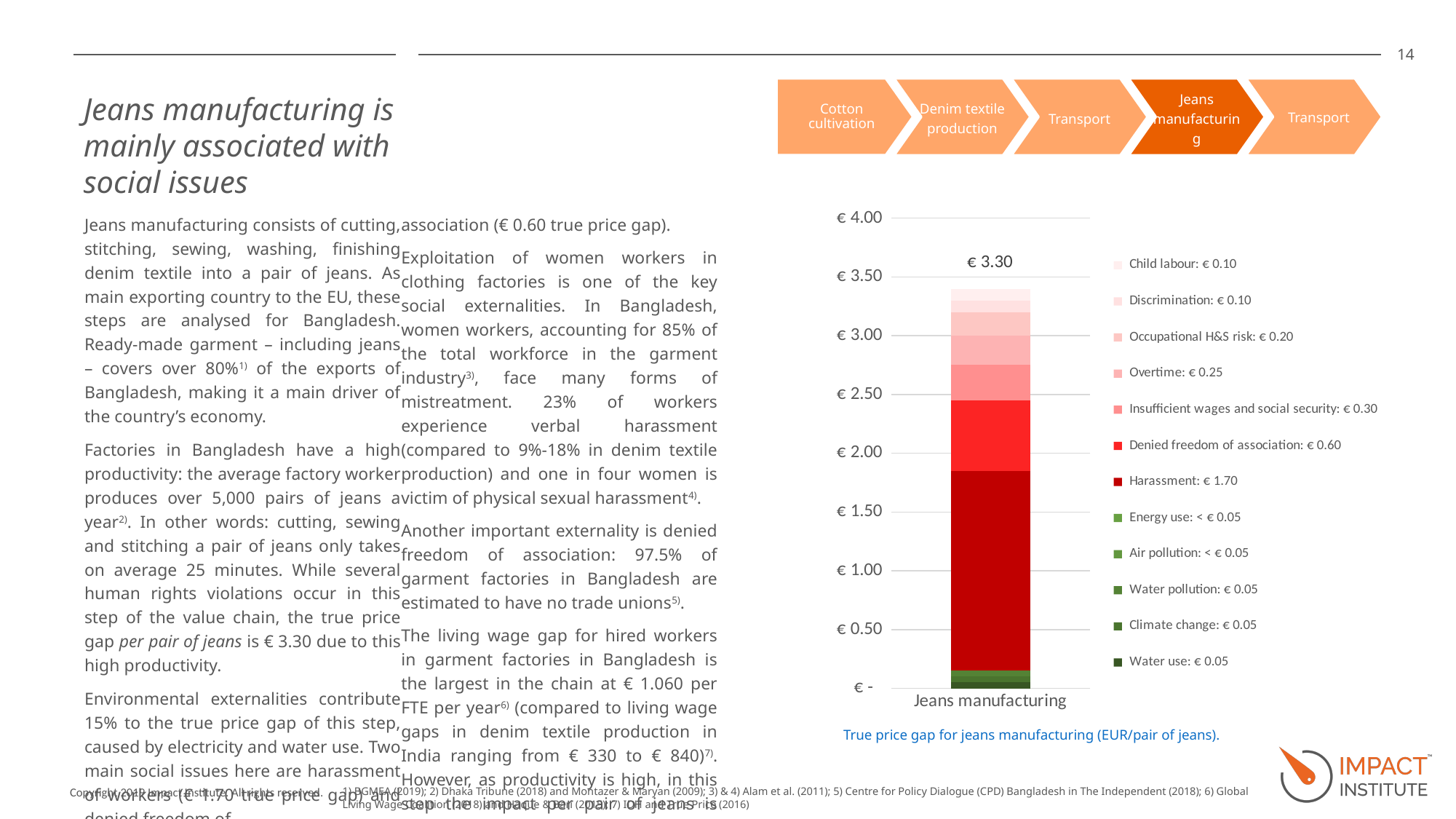
According to the legend, what is the value for Denied freedom of association? € 0.60 What is the difference between the Harassment value and the Denied freedom of association value? € 1.10 According to the legend, what is the value for Overtime? € 0.25 What is the total true price gap shown on top of the stacked bar for Jeans manufacturing? € 3.30 Is the total height of the Jeans manufacturing bar greater or less than € 3.00? greater What kind of chart is shown on the slide? Stacked bar chart According to the legend, what is the value for Insufficient wages and social security? € 0.30 What is the caption printed below the chart? True price gap for jeans manufacturing (EUR/pair of jeans). How many entries does the chart legend list? 12 Which is larger: the value for Occupational H&S risk or the value for Overtime? Overtime According to the legend, what is the true price gap value for Harassment? € 1.70 Which legend entry has the largest value in the stacked bar? Harassment